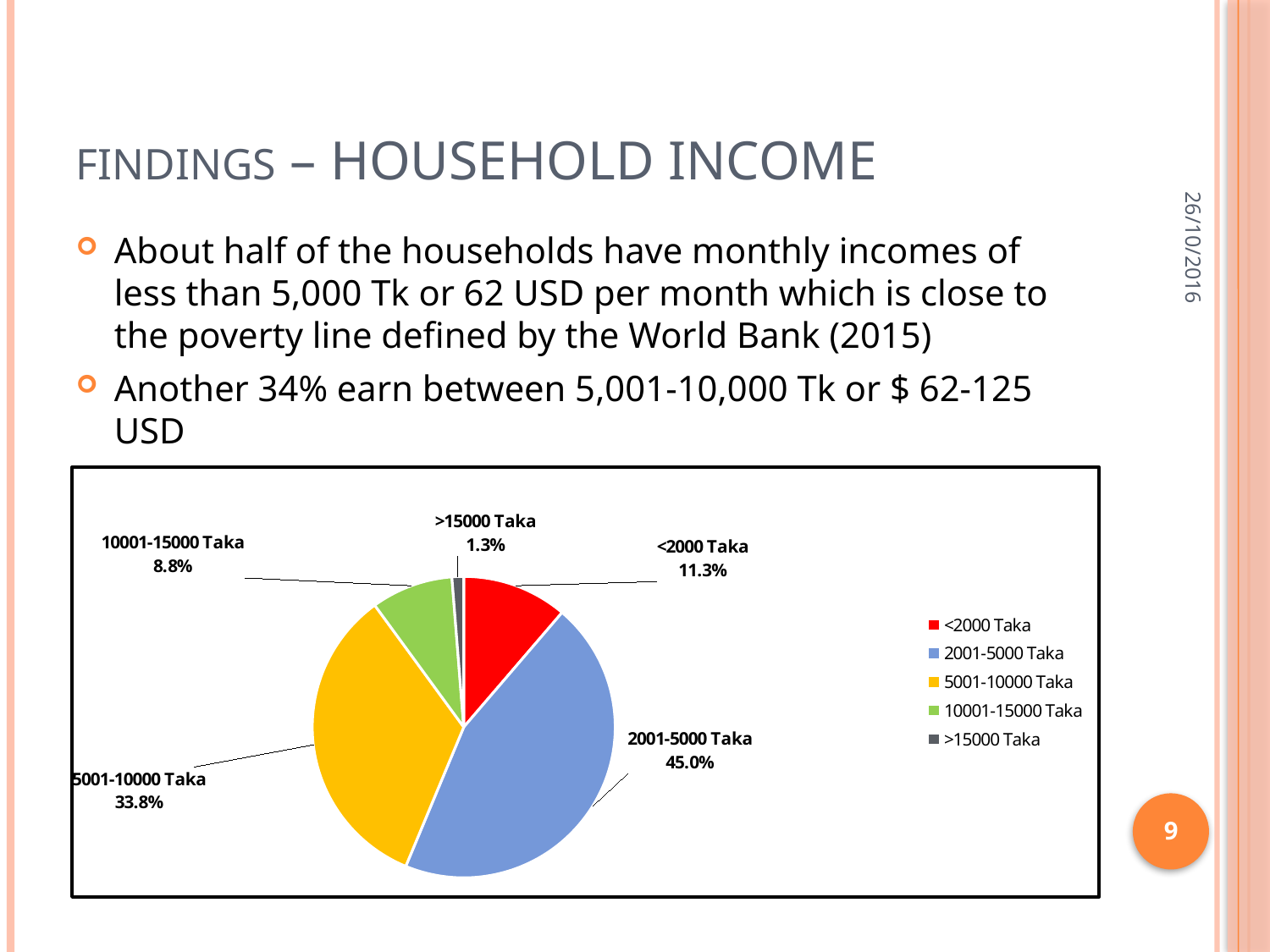
What colour is the slice for 5001-10000 Taka? yellow What share of households have a monthly income of 10001-15000 Taka? 8.8% What share of households have a monthly income of 2001-5000 Taka? 45.0% How many income categories are shown in the pie chart? 5 Which income category has the largest share of households? 2001-5000 Taka What share of households have a monthly income of <2000 Taka? 11.3% What share of households have a monthly income of 5001-10000 Taka? 33.8% Which slice is larger: <2000 Taka or 10001-15000 Taka? <2000 Taka Which income category has the smallest share of households? >15000 Taka What kind of chart is shown on the slide? pie chart What is the difference in percentage points between the 2001-5000 Taka and 5001-10000 Taka slices? 11.2 What share of households have a monthly income of >15000 Taka? 1.3%